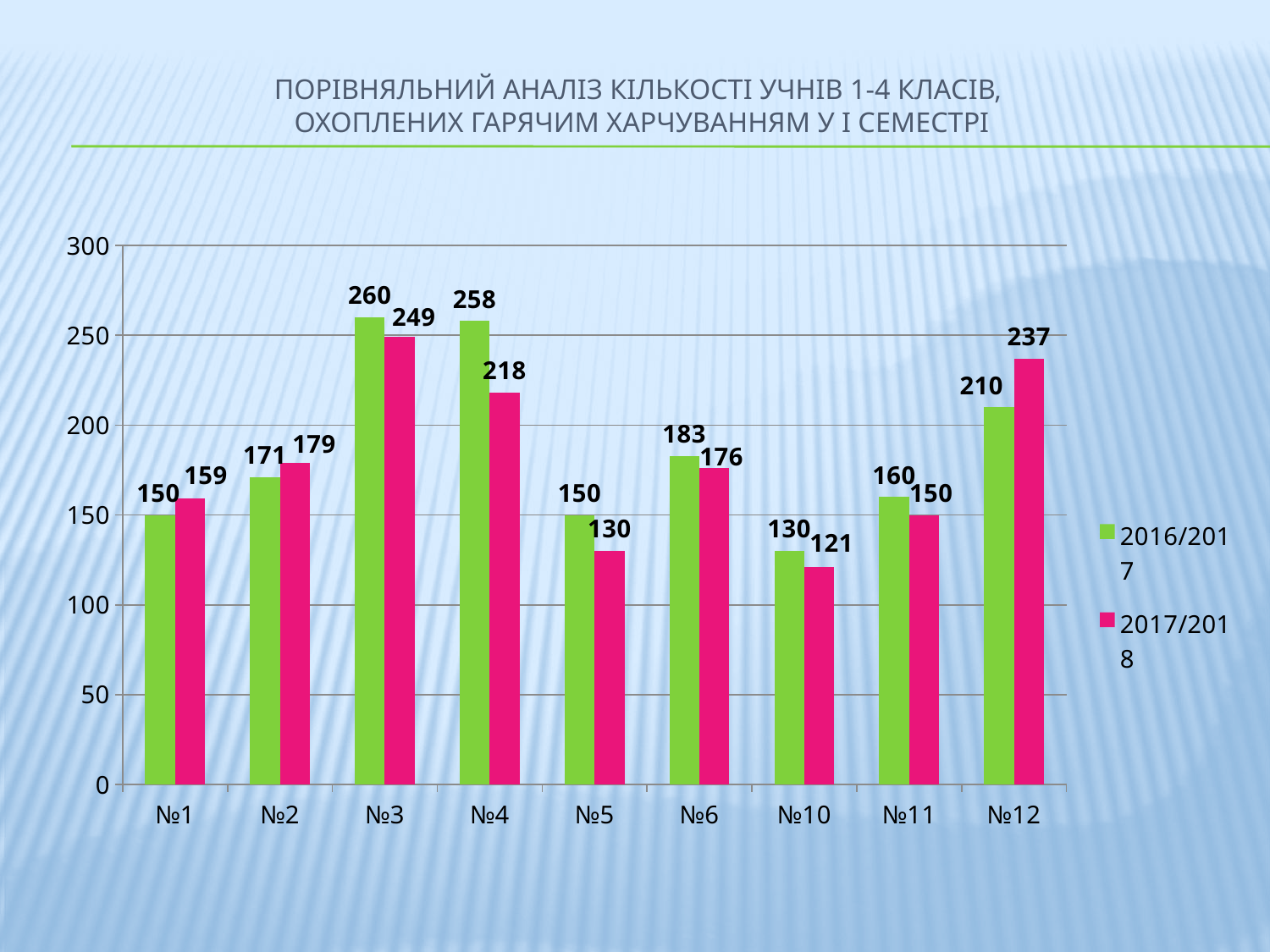
What is the difference between the 2017/2018 values for №3 and №10? 128 Which is larger for №12: the 2016/2017 value or the 2017/2018 value? 2017/2018 What is the value for №3 in the 2016/2017 series? 260 Which category has the highest value in the 2017/2018 series? №3 What kind of chart is shown on the slide? bar chart How many categories are shown on the x axis? 9 Is the 2017/2018 value for №5 greater or less than 150? less How many series does the legend list? 2 What is the value for №12 in the 2017/2018 series? 237 Which colour represents the 2016/2017 series? green Which category has the lowest value in the 2016/2017 series? №10 What is the difference between the 2016/2017 and 2017/2018 values for №4? 40